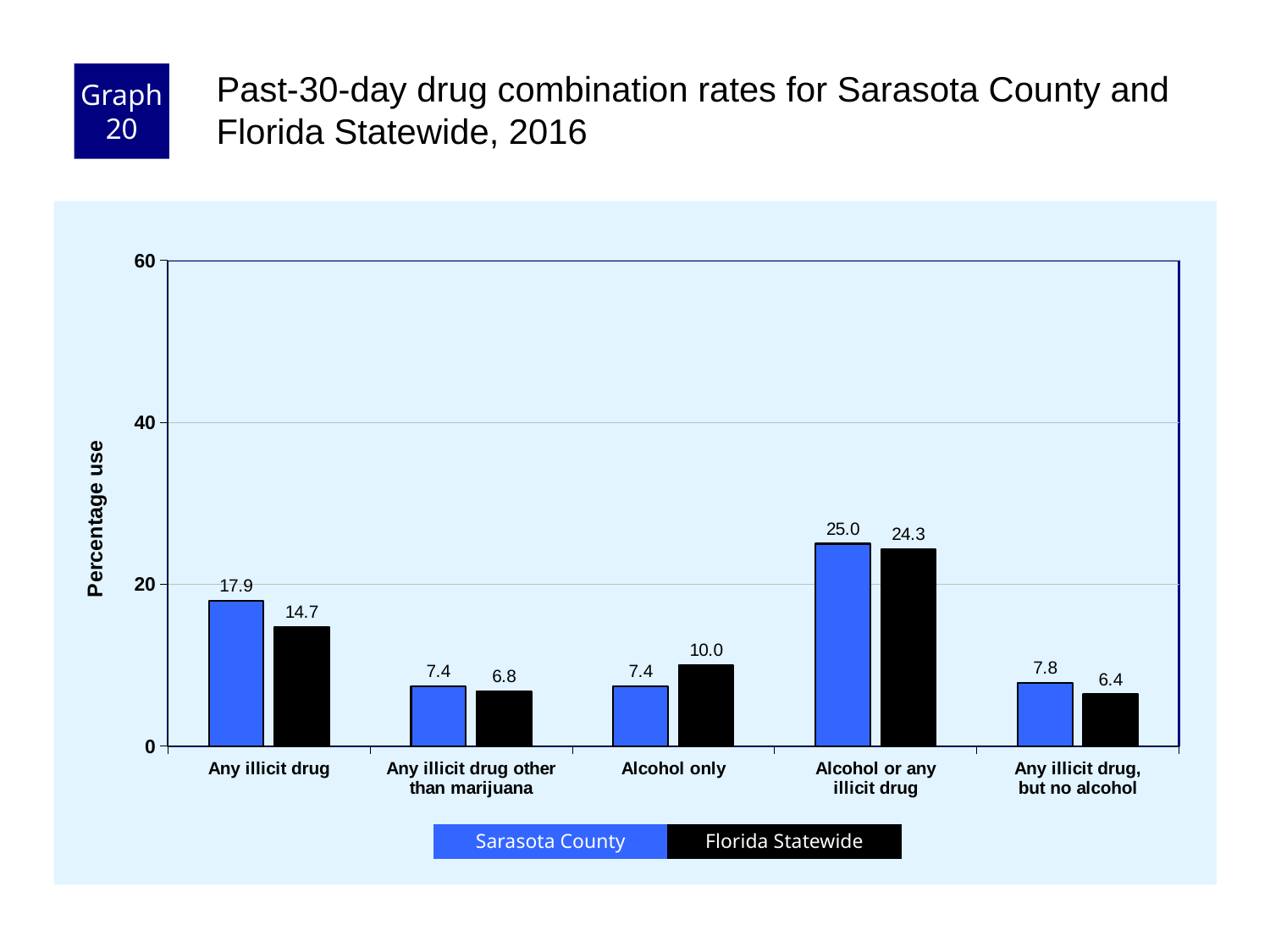
What is the Florida Statewide value for Any illicit drug, but no alcohol? 6.4 How many series does the legend list? 2 Which is larger for Alcohol only: the Sarasota County value or the Florida Statewide value? Florida Statewide What is the difference between the Sarasota County and Florida Statewide values for Any illicit drug? 3.2 What kind of chart is shown on the slide? bar chart Which category has the highest Sarasota County value? Alcohol or any illicit drug Which category has the lowest Florida Statewide value? Any illicit drug, but no alcohol How many categories are shown on the x axis? 5 What is the Florida Statewide value for Alcohol only? 10.0 What is the label of the y axis? Percentage use What is the Sarasota County value for Any illicit drug? 17.9 Is the Florida Statewide value for Alcohol or any illicit drug greater or less than 20? greater